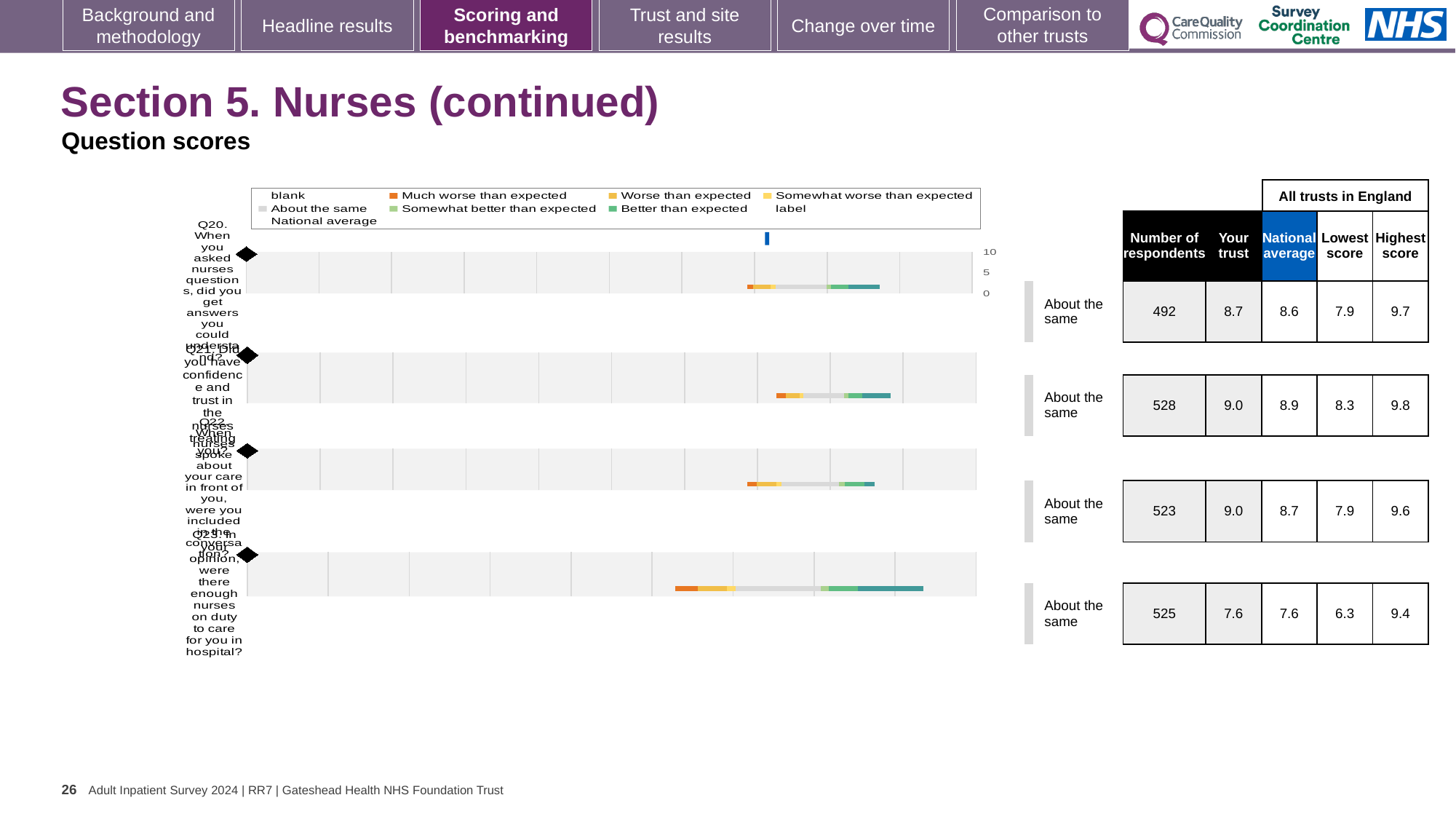
For Q22, which is larger: the 'Your trust' score or the national average? Your trust What is the national average score for Q20? 8.6 Which question has the lowest 'Your trust' score? Q23 What is the maximum value shown on the chart's score axis? 10 What is the highest score among all trusts in England for Q21? 9.8 What kind of chart is used to show the question scores on this slide? bar chart What is the difference between the highest score and the lowest score for Q20? 1.8 What is the 'Your trust' score for Q23 (were there enough nurses on duty)? 7.6 What benchmark category is shown for Q23? About the same How many respondents answered Q21 (confidence and trust in the nurses)? 528 What is the difference between the highest score and the lowest score for Q23? 3.1 How many questions (Q20 to Q23) are plotted in the chart? 4